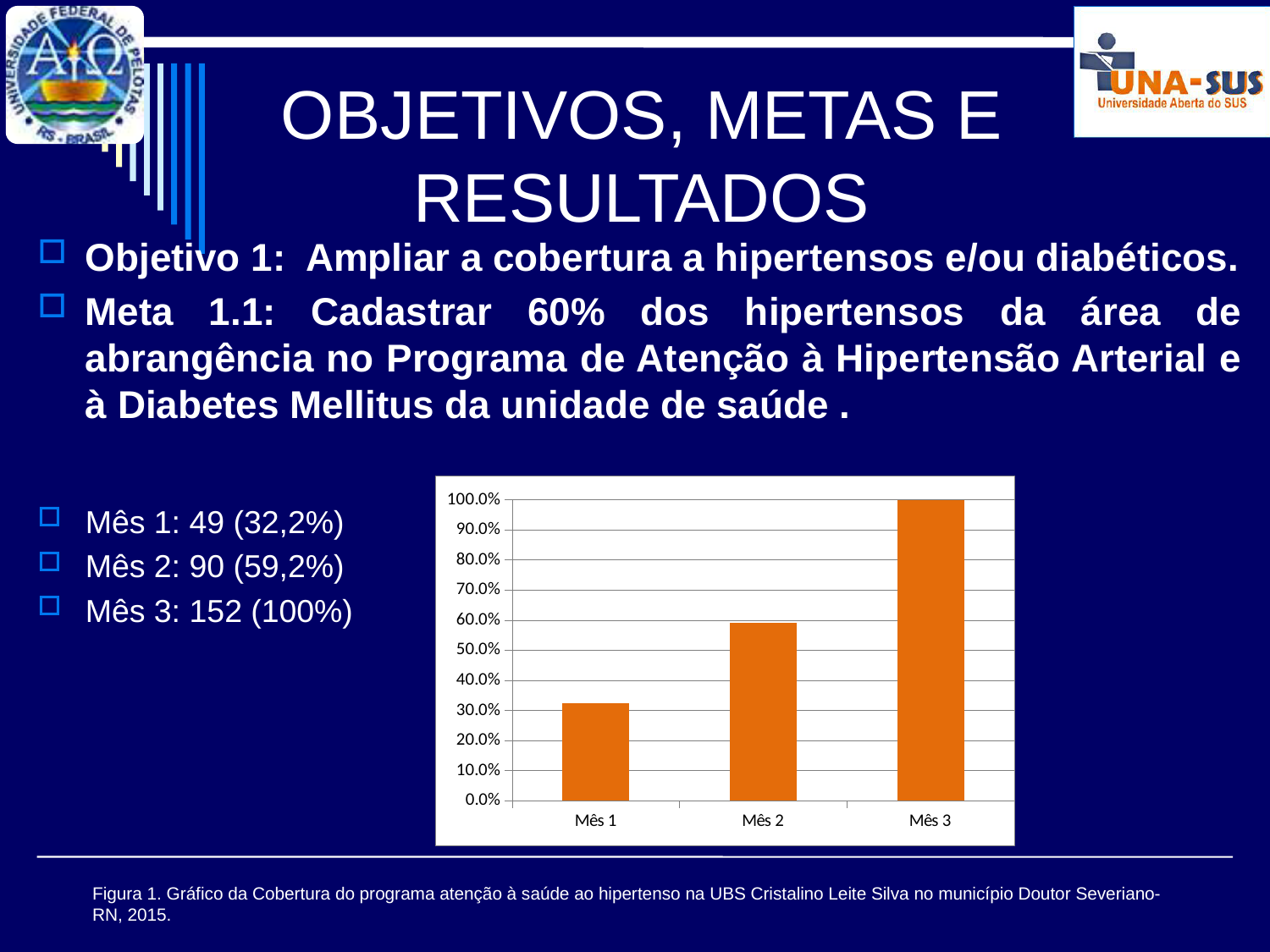
What type of chart is shown on the slide? bar chart How many categories (months) are plotted on the chart? 3 Is the value for Mês 1 greater or less than 30.0%? greater What is the highest tick value shown on the vertical axis of the chart? 100.0% Which month has the lowest coverage value in the chart? Mês 1 Is the value for Mês 2 greater or less than 60.0%? less Which month has the highest coverage value in the chart? Mês 3 What is the coverage value for Mês 3 in the chart? 100.0% Do the values rise or fall from Mês 1 to Mês 3? rise Is the value for Mês 1 greater or less than 40.0%? less Which is larger, the value for Mês 1 or the value for Mês 2? Mês 2